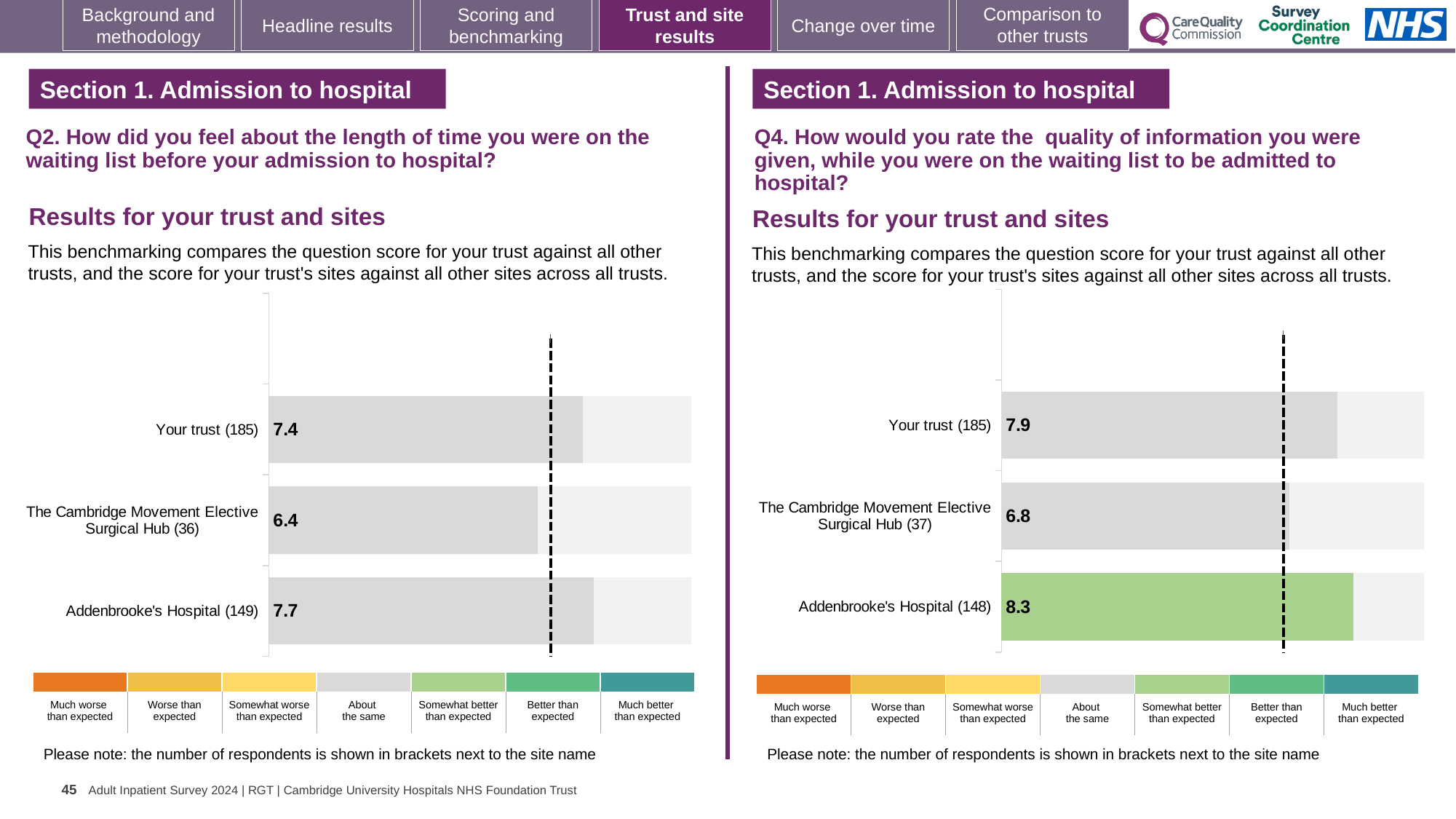
In the Q2 chart on the left, what is the score for Your trust? 7.4 In the Q4 chart on the right, what is the score for Addenbrooke's Hospital? 8.3 In the Q4 chart on the right, which has the larger score: Your trust or The Cambridge Movement Elective Surgical Hub? Your trust In the Q4 chart on the right, which bar is coloured green rather than grey? Addenbrooke's Hospital In the Q4 chart on the right, what is the difference between the scores for Addenbrooke's Hospital and Your trust? 0.4 In the Q2 chart on the left, what is the score for The Cambridge Movement Elective Surgical Hub? 6.4 In the Q4 chart on the right, what is the score for Your trust? 7.9 What type of chart is used for the Q4 results on the right? Bar chart In the Q2 chart on the left, which site or trust has the highest score? Addenbrooke's Hospital In the Q2 chart on the left, what is the difference between the scores for Addenbrooke's Hospital and The Cambridge Movement Elective Surgical Hub? 1.3 In the Q4 chart on the right, which site or trust has the lowest score? The Cambridge Movement Elective Surgical Hub How many bars are plotted in the Q2 chart on the left? 3